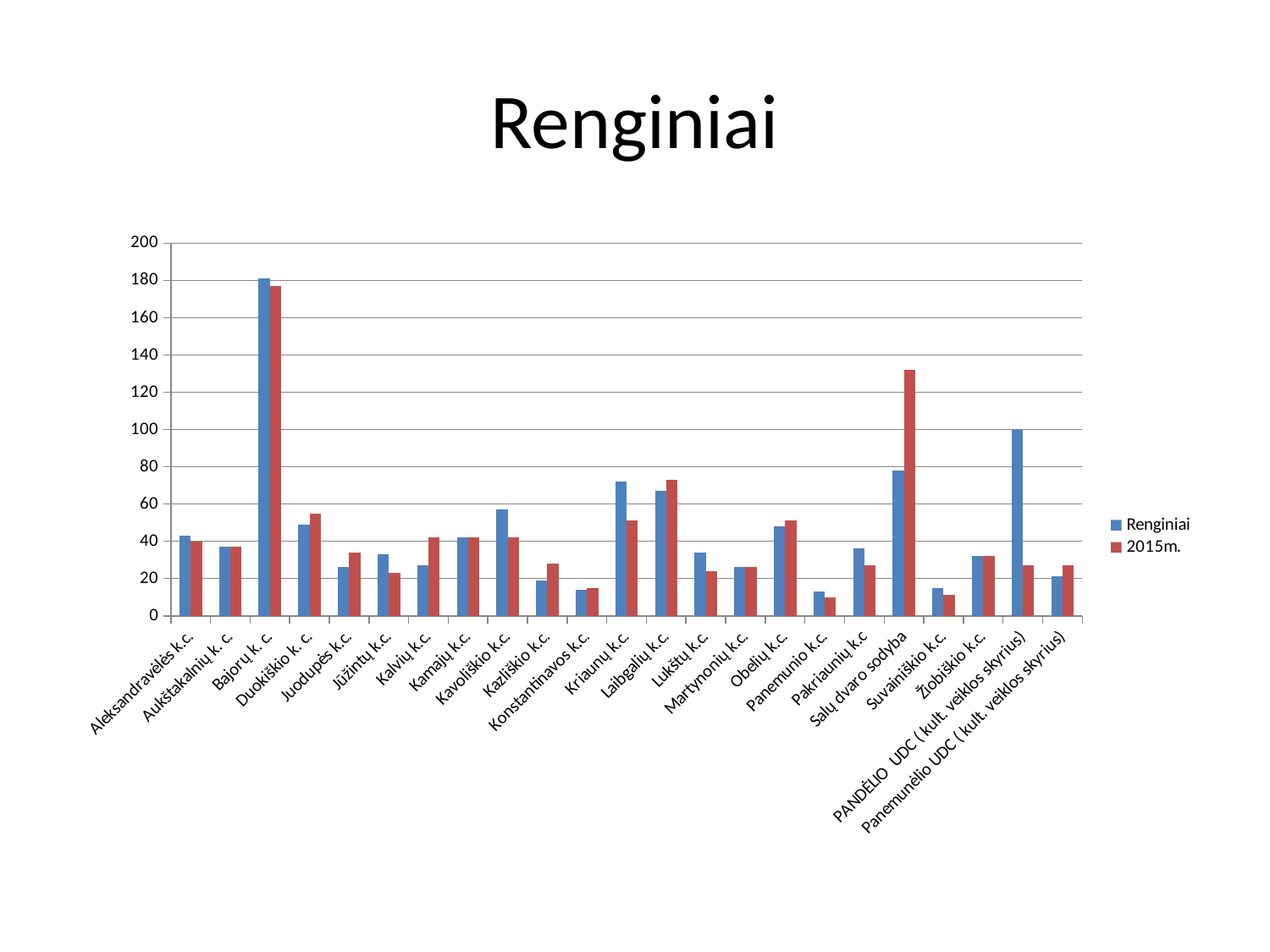
Which category has the highest value for the 2015m. series? Bajorų k. c. What is the title of the chart? Renginiai Which colour represents the 2015m. series in the legend? red For Salų dvaro sodyba, which series has the larger value, Renginiai or 2015m.? 2015m. Which category has the highest value for the Renginiai series? Bajorų k. c. How many categories are shown on the x axis? 23 Is the 2015m. value for Konstantinavos k.c. greater or less than 20? less What kind of chart is shown on the slide? bar chart Is the Renginiai value for Bajorų k. c. greater or less than 160? greater How many series does the legend list? 2 Is the 2015m. value for Salų dvaro sodyba greater or less than 120? greater For PANDĖLIO UDC (kult. veiklos skyrius), which series has the larger value, Renginiai or 2015m.? Renginiai